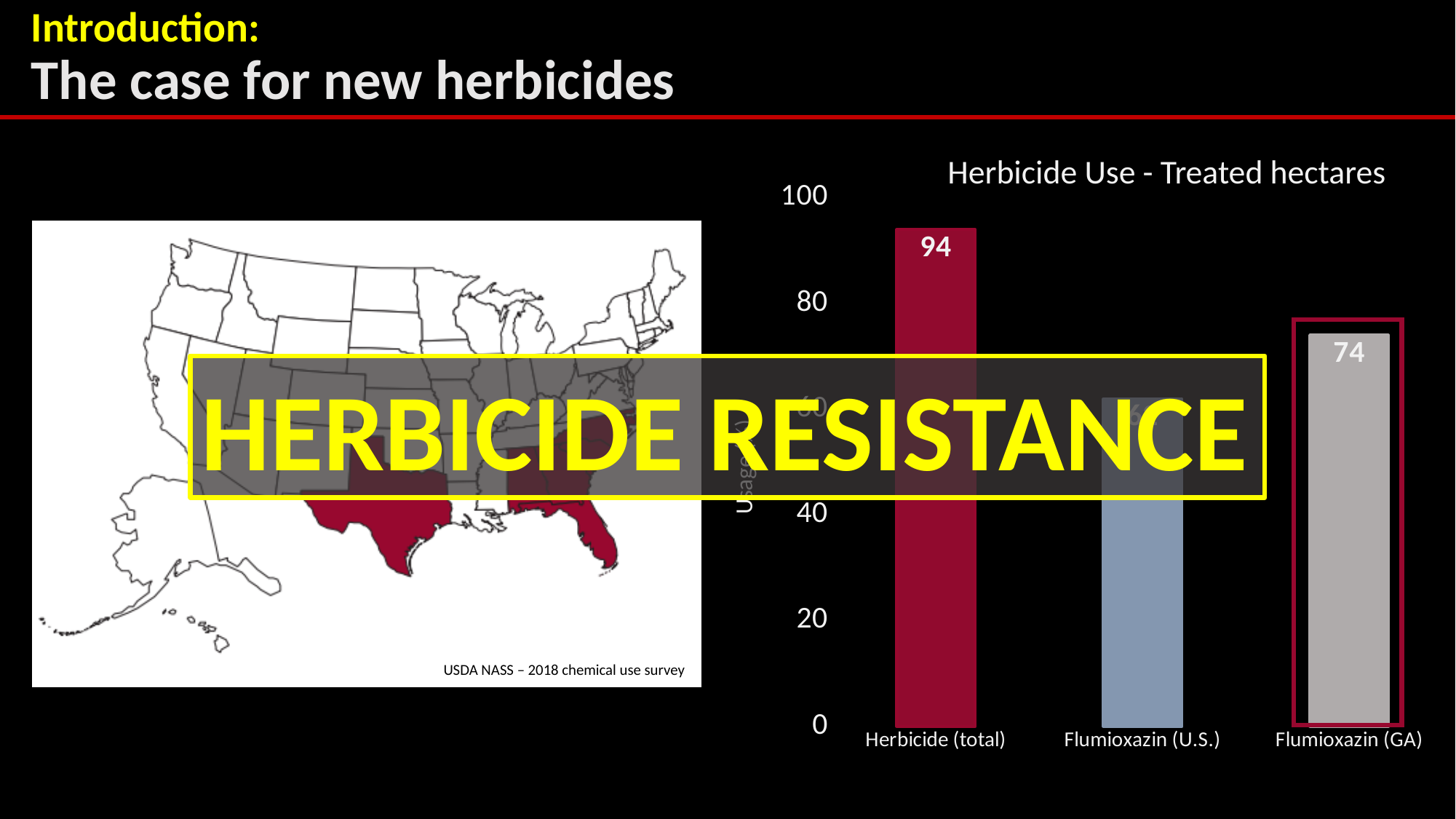
How many categories are shown in the Herbicide Use - Treated hectares chart? 3 What is the value for Herbicide (total) in the Herbicide Use - Treated hectares chart? 94 Is the value for Flumioxazin (U.S.) greater or less than 40? greater What is the title of the chart on the slide? Herbicide Use - Treated hectares What is the difference between the values for Herbicide (total) and Flumioxazin (GA)? 20 What is the value for Flumioxazin (GA) in the Herbicide Use - Treated hectares chart? 74 What kind of chart is the Herbicide Use - Treated hectares chart? bar chart Which category has the lowest value in the Herbicide Use - Treated hectares chart? Flumioxazin (U.S.) Which bar in the chart is outlined with a red border? Flumioxazin (GA) Which category has the highest value in the Herbicide Use - Treated hectares chart? Herbicide (total) Which is larger, the value for Herbicide (total) or the value for Flumioxazin (GA)? Herbicide (total) Is the value for Flumioxazin (U.S.) greater or less than 80? less